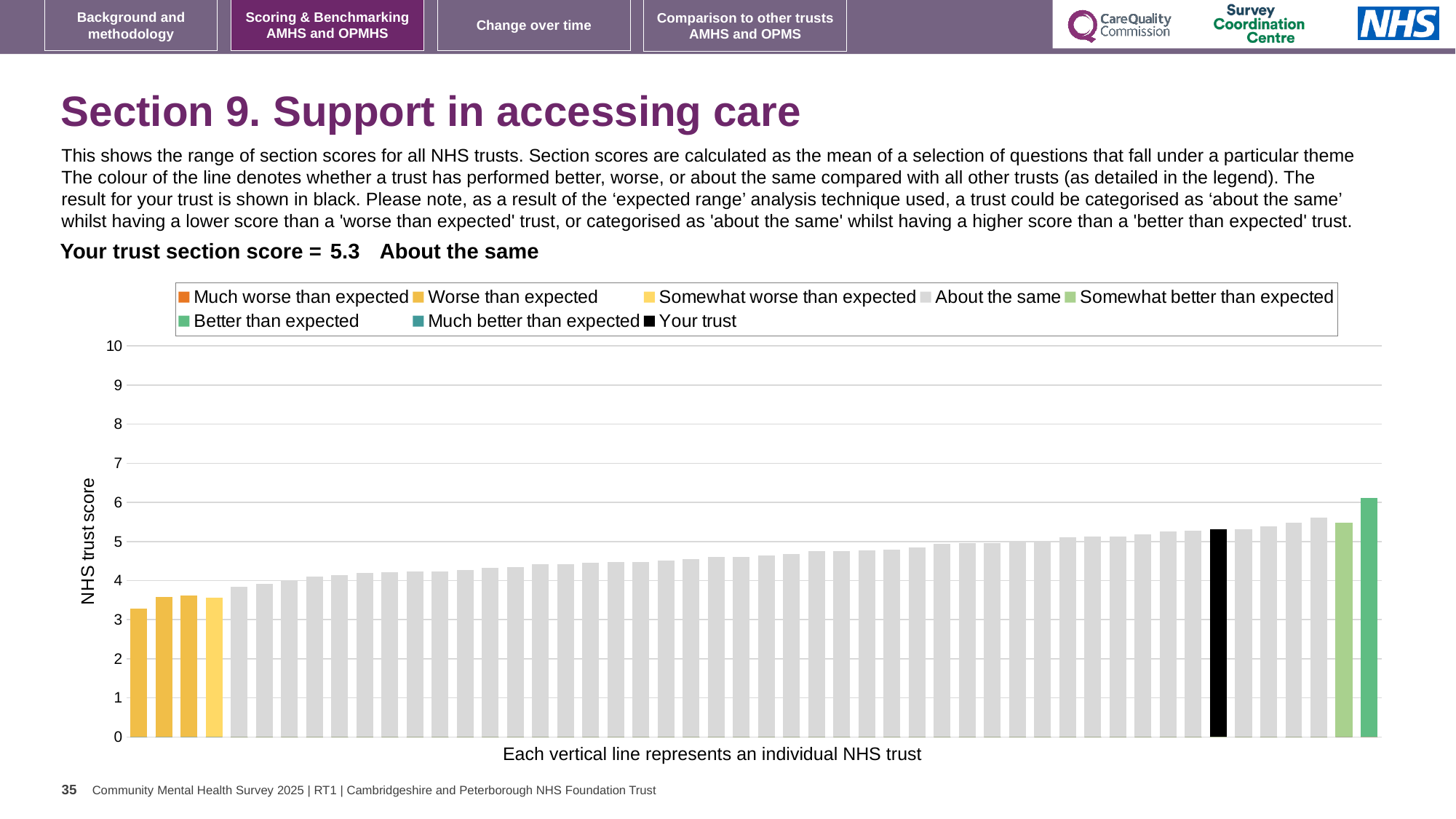
Is the value of the black 'Your trust' bar greater or less than 5? greater How many bars are coloured as 'Worse than expected'? 3 Which category is your trust placed in for this section? About the same What is the section score for your trust shown on the slide? 5.3 What is the label on the vertical axis of the chart? NHS trust score Do the bar values rise or fall from left to right across the chart? rise Which legend category do the shortest bars belong to? Worse than expected Which legend category does the tallest bar belong to? Better than expected How many entries does the chart legend list? 8 Is the value of the rightmost bar greater or less than 6? greater Is the value of the leftmost bar greater or less than 4? less What kind of chart is shown on the slide? bar chart